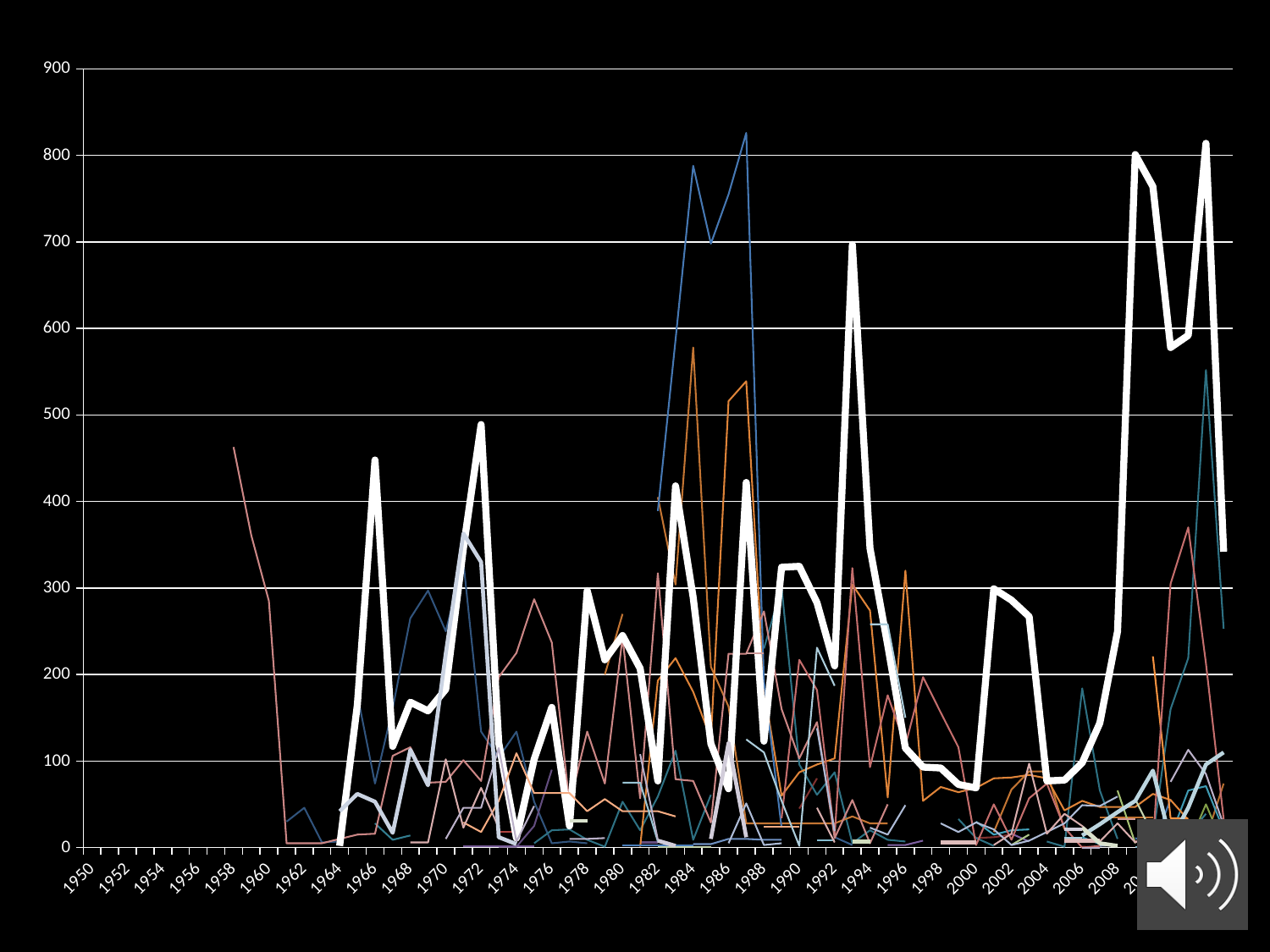
Is the value of the thick white line in 2000 greater or less than 100? less Is the value of the thick white line in 2008 greater or less than 500? less What is the first year label on the horizontal axis? 1950 Is the value of the thick white line in 1966 greater or less than 400? greater Does the chart display a legend identifying the series? No What is the highest value shown on the vertical axis? 900 Does the thick white line rise or fall between 1964 and 1966? rise What type of chart is shown on the slide? line chart